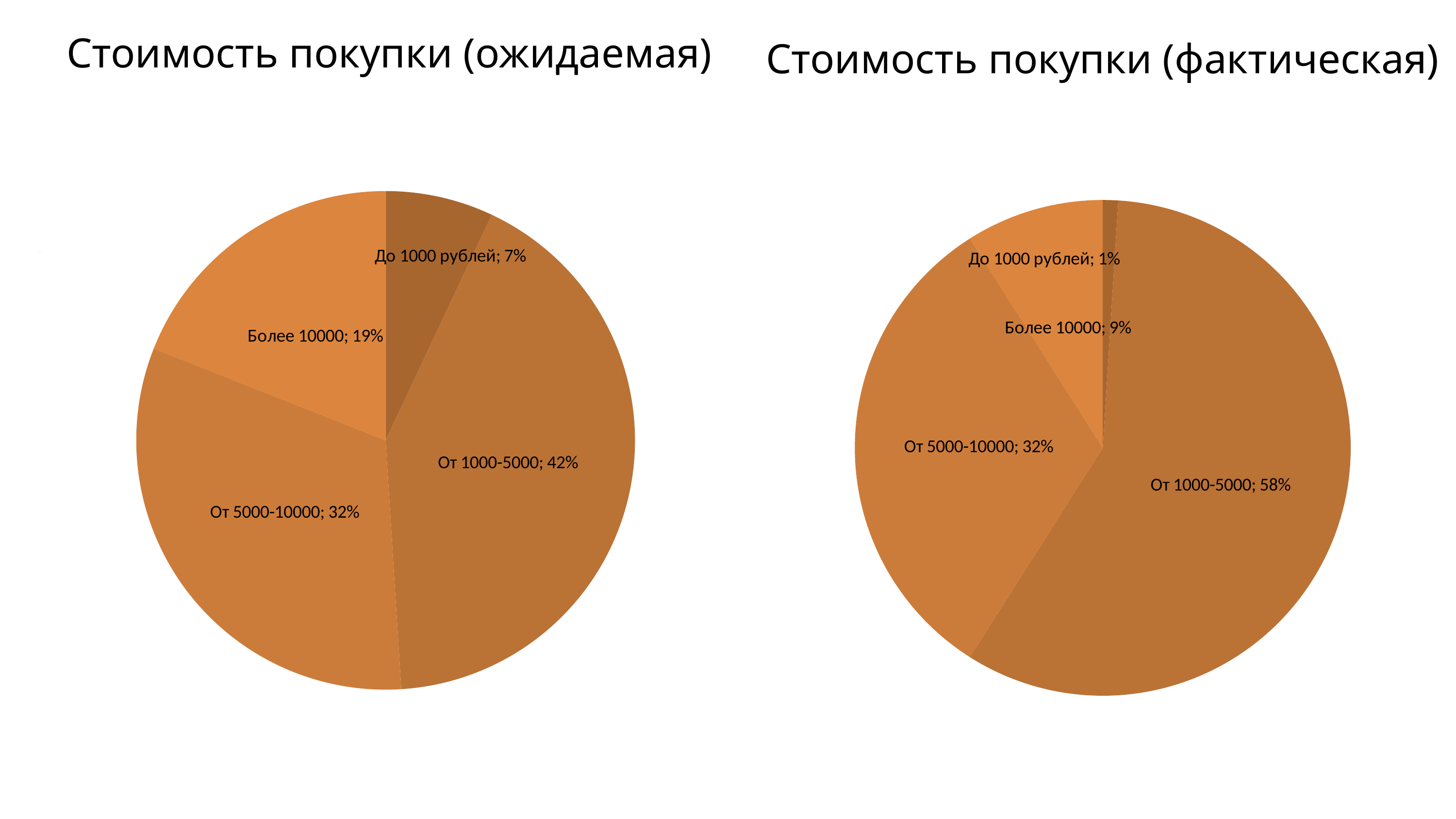
In the chart titled "Стоимость покупки (ожидаемая)", which category has the smallest share? До 1000 рублей How many slices does the chart titled "Стоимость покупки (ожидаемая)" have? 4 In the chart titled "Стоимость покупки (ожидаемая)", what is the value for "Более 10000"? 19% In the chart titled "Стоимость покупки (ожидаемая)", what is the difference between "От 1000-5000" and "От 5000-10000"? 10% In the chart titled "Стоимость покупки (фактическая)", what is the value for "До 1000 рублей"? 1% In the chart titled "Стоимость покупки (фактическая)", which category has the smallest share? До 1000 рублей In the chart titled "Стоимость покупки (фактическая)", what is the difference between "От 1000-5000" and "От 5000-10000"? 26% In the chart titled "Стоимость покупки (ожидаемая)", which category has the largest share? От 1000-5000 In the chart titled "Стоимость покупки (фактическая)", which is larger: "Более 10000" or "От 5000-10000"? От 5000-10000 In the chart titled "Стоимость покупки (ожидаемая)", what share does "От 1000-5000" have? 42% What type of chart is the chart titled "Стоимость покупки (фактическая)"? Pie chart In the chart titled "Стоимость покупки (фактическая)", what share does "От 1000-5000" have? 58%